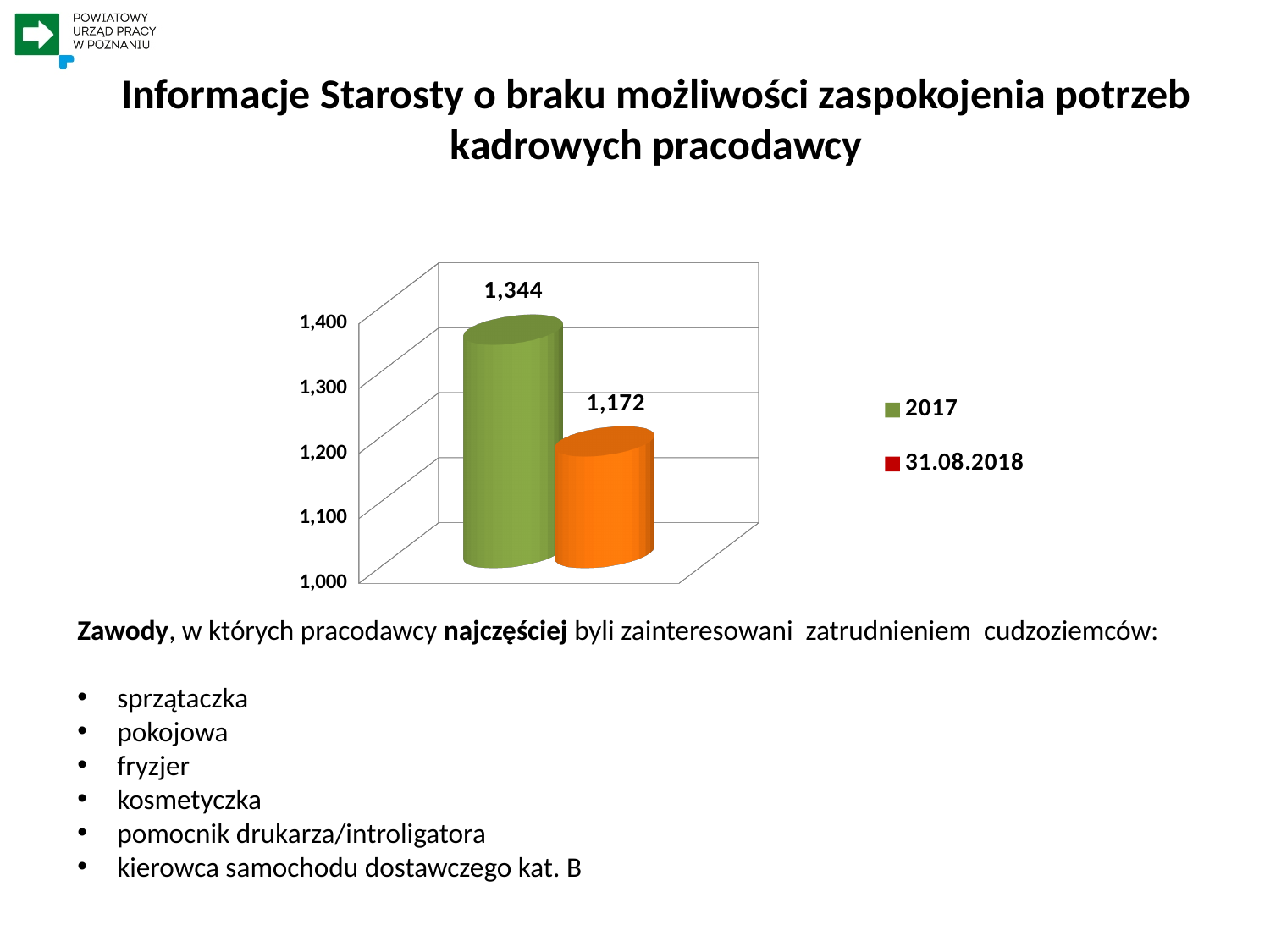
What is the lowest value shown on the vertical axis? 1,000 Is the value for 31.08.2018 greater or less than 1,200? less What colour is the bar for 2017? green What kind of chart is shown on the slide? bar chart What is the difference between the 2017 value and the 31.08.2018 value? 172 How many series does the legend list? 2 What is the value for 31.08.2018? 1,172 Is the value for 2017 greater or less than 1,300? greater What is the value for 2017? 1,344 Which series has the higher value, 2017 or 31.08.2018? 2017 Do the values rise or fall from 2017 to 31.08.2018? fall Which series has the lowest value? 31.08.2018